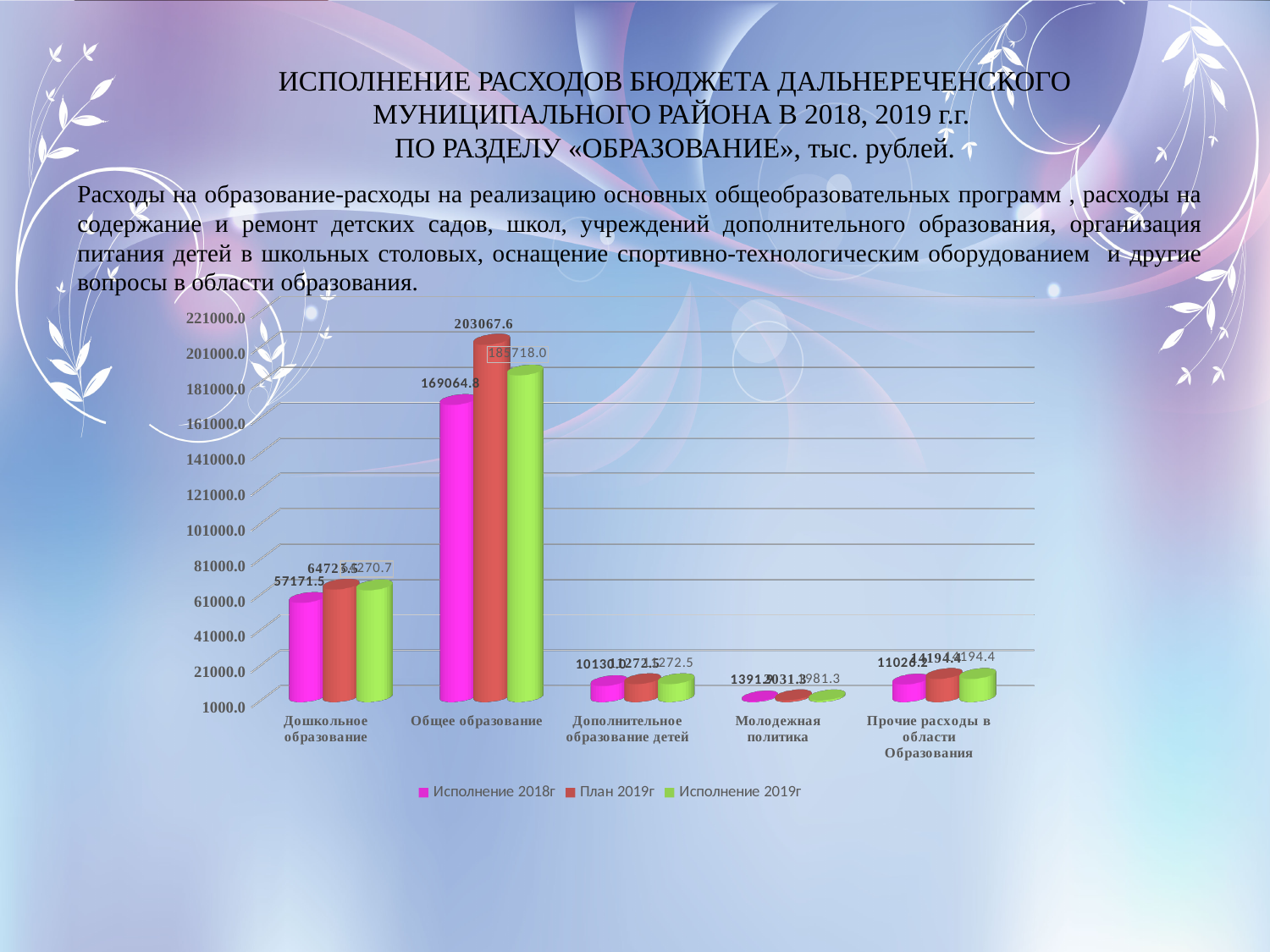
How many categories are shown on the x axis of the chart? 5 What is the value of Исполнение 2018г for Дошкольное образование? 57171.5 What is the value of Исполнение 2019г for Общее образование? 185718.0 What is the value of Исполнение 2018г for Общее образование? 169064.8 Which series is shown in green in the legend? Исполнение 2019г What type of chart is shown on the slide? Bar chart What is the value of План 2019г for Общее образование? 203067.6 How many series does the chart legend list? 3 Which category has the highest values across all series? Общее образование Which category has the lowest values across all series? Молодежная политика What is the difference between План 2019г and Исполнение 2019г for Общее образование? 17349.6 For Общее образование, which is larger: План 2019г or Исполнение 2019г? План 2019г